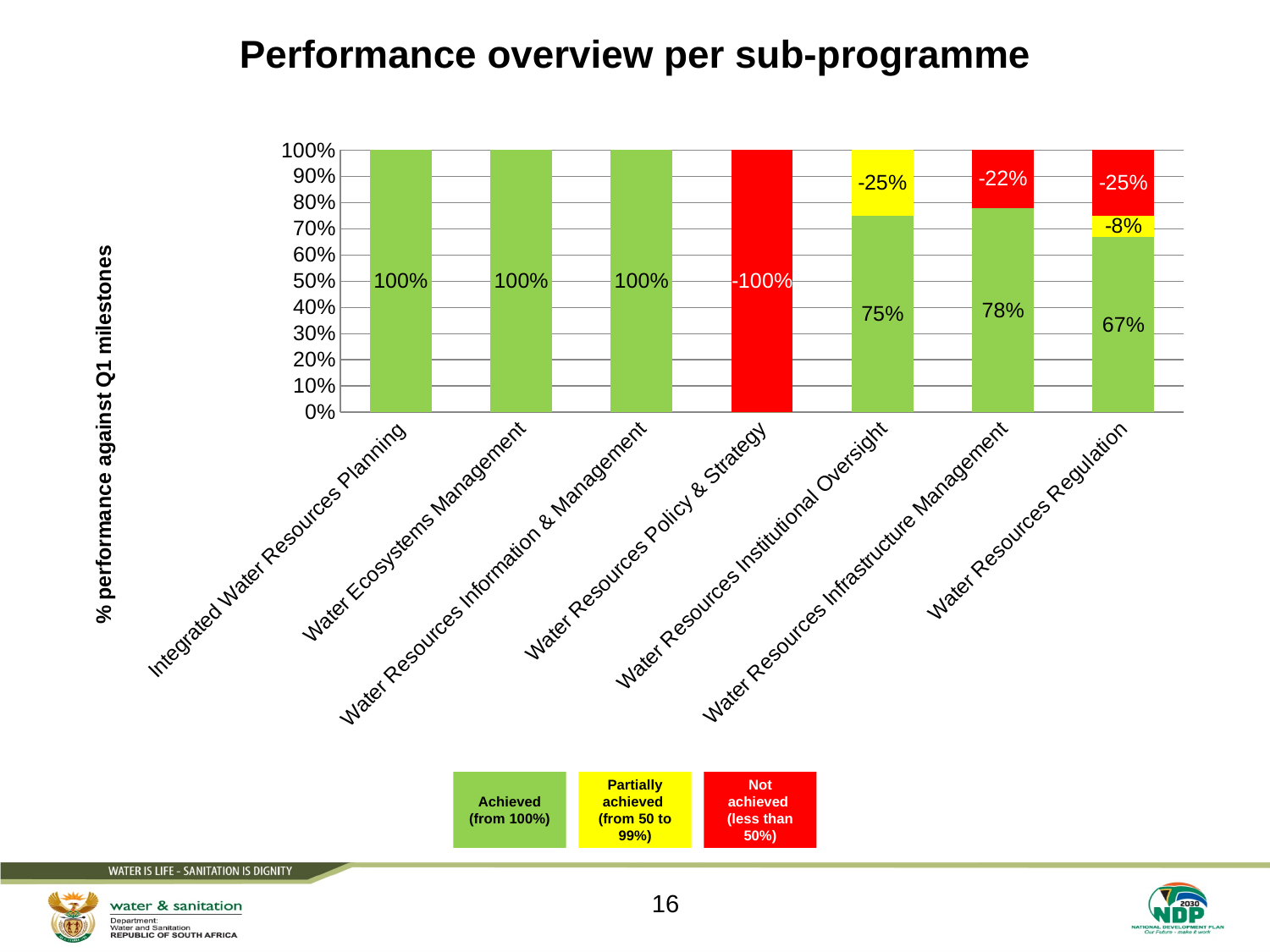
What value is labelled on the yellow segment for Water Resources Regulation? -8% How many sub-programmes are shown on the x axis of the chart? 7 What value is labelled on the red bar for Water Resources Policy & Strategy? -100% How many sub-programmes show a green value of 100%? 3 What is the green (achieved) value shown for Water Resources Regulation? 67% What is the title of the vertical axis of the chart? % performance against Q1 milestones What is the difference between the green values for Water Resources Infrastructure Management (78%) and Water Resources Regulation (67%)? 11% Which has the larger green (achieved) value: Water Resources Institutional Oversight or Water Resources Infrastructure Management? Water Resources Infrastructure Management What is the green (achieved) value shown for Water Resources Institutional Oversight? 75% What is the green (achieved) value shown for Water Resources Infrastructure Management? 78% What kind of chart is shown on the slide? Bar chart What value is labelled on the red segment for Water Resources Infrastructure Management? -22%